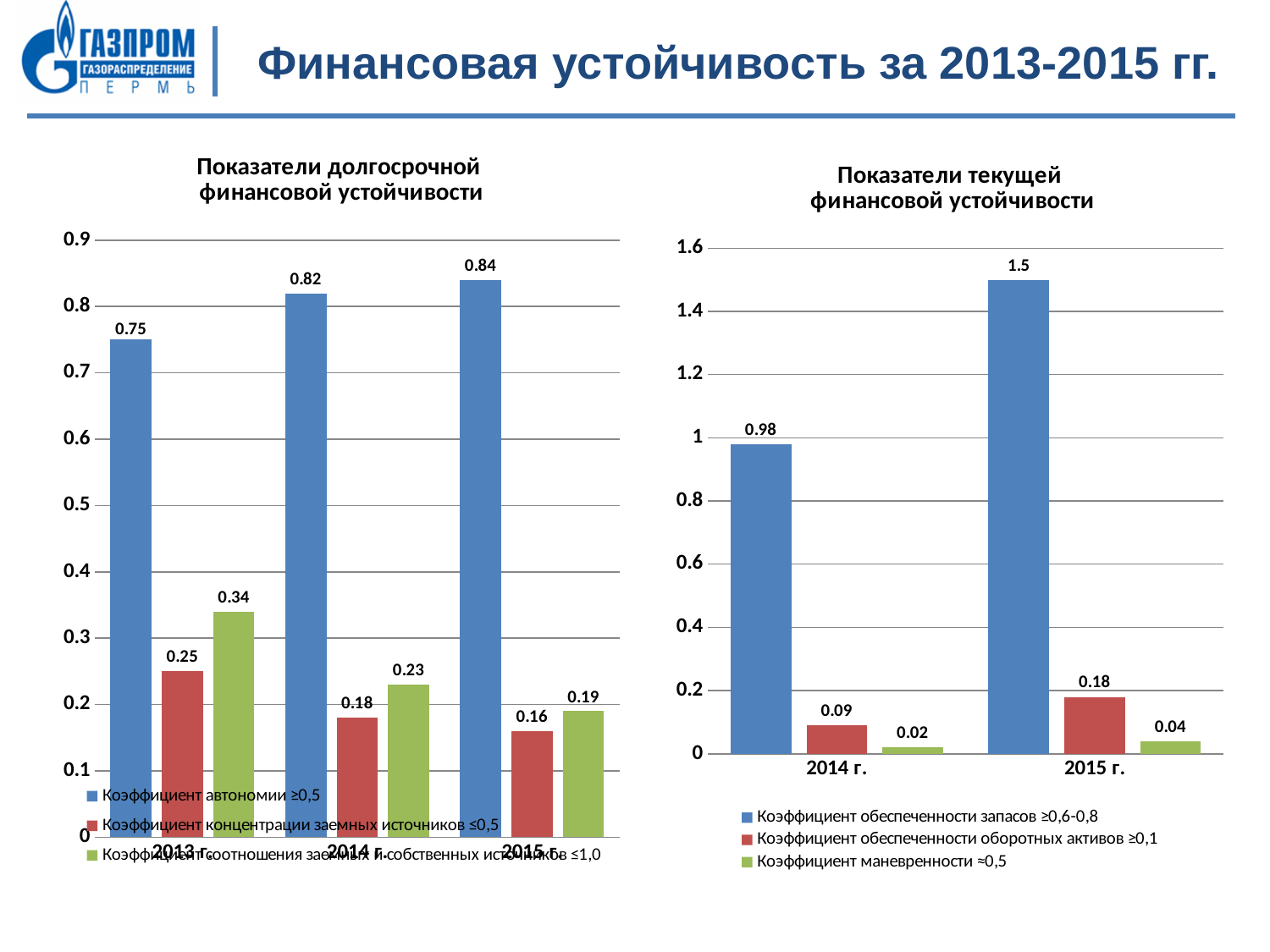
In the chart 'Показатели долгосрочной финансовой устойчивости', in which year is Коэффициент автономии highest? 2015 г. In the chart 'Показатели текущей финансовой устойчивости', what is the value of Коэффициент обеспеченности запасов for 2015 г.? 1.5 What type of chart is 'Показатели текущей финансовой устойчивости'? bar chart In the chart 'Показатели текущей финансовой устойчивости', how many year categories are shown on the x axis? 2 In the chart 'Показатели долгосрочной финансовой устойчивости', what is the value of Коэффициент соотношения заемных и собственных источников for 2014 г.? 0.23 In the chart 'Показатели долгосрочной финансовой устойчивости', how many series does the legend list? 3 In the chart 'Показатели долгосрочной финансовой устойчивости', what is the difference between Коэффициент автономии in 2015 г. and in 2013 г.? 0.09 In the chart 'Показатели долгосрочной финансовой устойчивости', does Коэффициент автономии rise or fall from 2013 г. to 2015 г.? rise In the chart 'Показатели долгосрочной финансовой устойчивости', what is the value of Коэффициент автономии for 2013 г.? 0.75 In the chart 'Показатели текущей финансовой устойчивости', which is larger: Коэффициент обеспеченности оборотных активов in 2014 г. or in 2015 г.? 2015 г. In the chart 'Показатели долгосрочной финансовой устойчивости', in which year is Коэффициент концентрации заемных источников lowest? 2015 г. In the chart 'Показатели текущей финансовой устойчивости', what is the value of Коэффициент маневренности for 2014 г.? 0.02